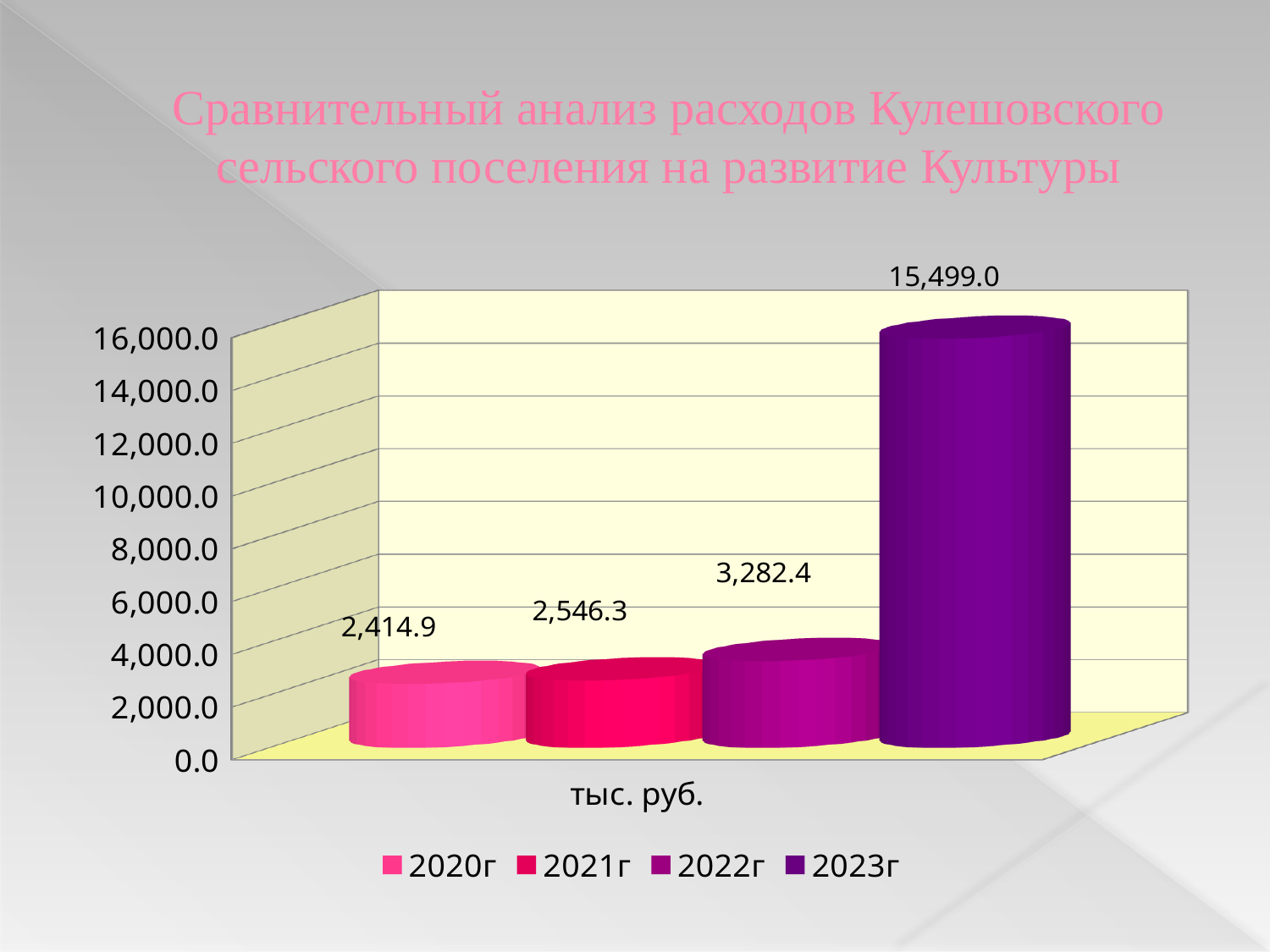
How many series does the legend list? 4 Which year has the lowest value? 2020г Do the values rise or fall from 2020г to 2023г? Rise What is the value for 2020г? 2,414.9 Which is larger, the value for 2022г or the value for 2021г? 2022г Which year has the highest value? 2023г What is the difference between the values for 2021г and 2020г? 131.4 What is the value for 2023г? 15,499.0 What is the value for 2022г? 3,282.4 What unit label is shown below the bars on the horizontal axis? тыс. руб. What kind of chart is shown on the slide? Bar chart What is the difference between the values for 2023г and 2022г? 12,216.6